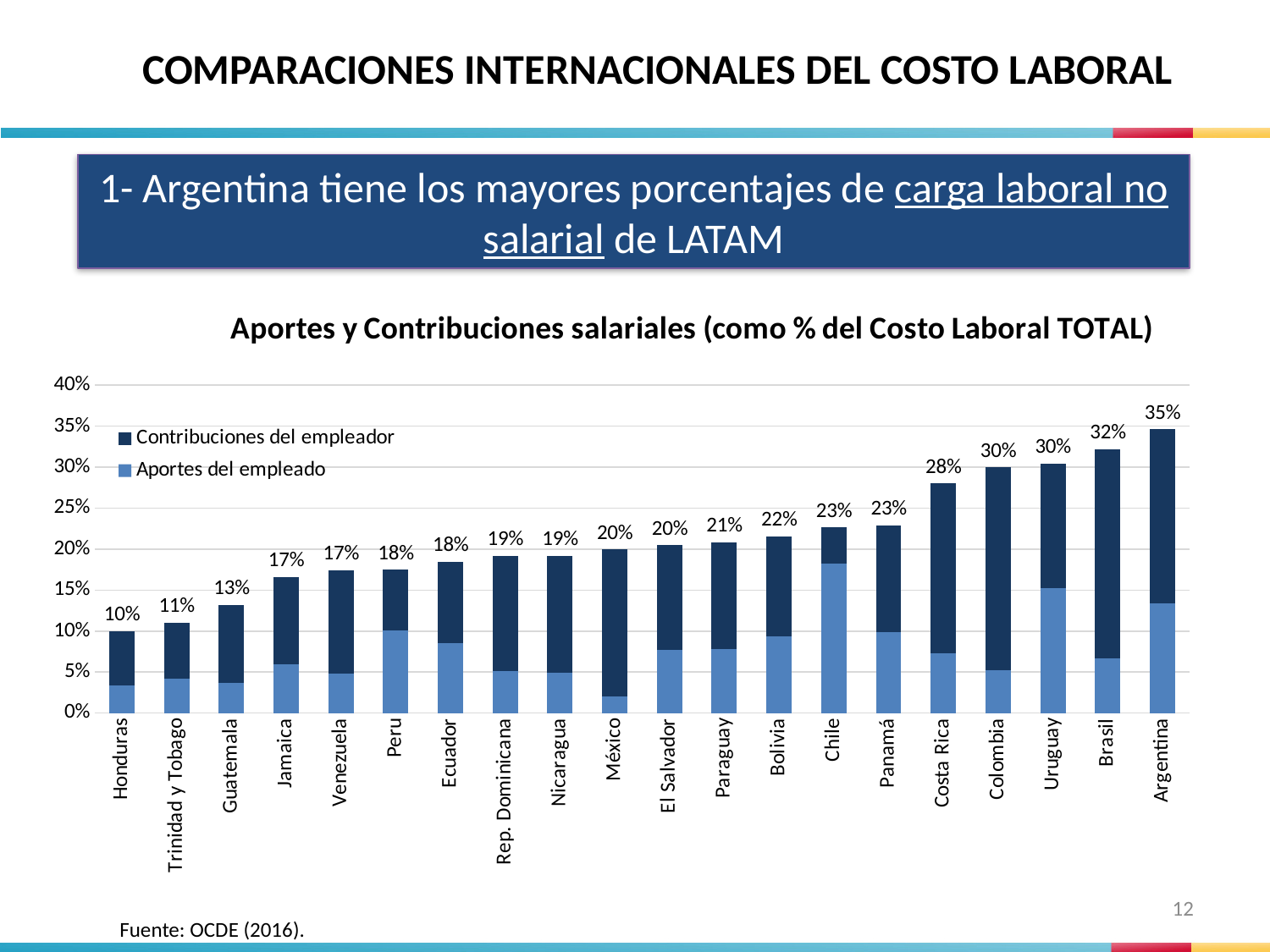
How many series does the legend list? 2 What is the total value shown for Costa Rica? 28% Is the Aportes del empleado value for México greater or less than 5%? less Is the Aportes del empleado value for Chile greater or less than 15%? greater Which country has the highest total in the chart? Argentina Which has a larger total, Colombia or Bolivia? Colombia What kind of chart is shown on the slide? Stacked bar chart Which country has the lowest total in the chart? Honduras What is the total value shown for Argentina? 35% What is the difference between the total for Argentina and the total for Brasil? 3% How many countries are shown in the chart? 20 What is the total value shown for Honduras? 10%